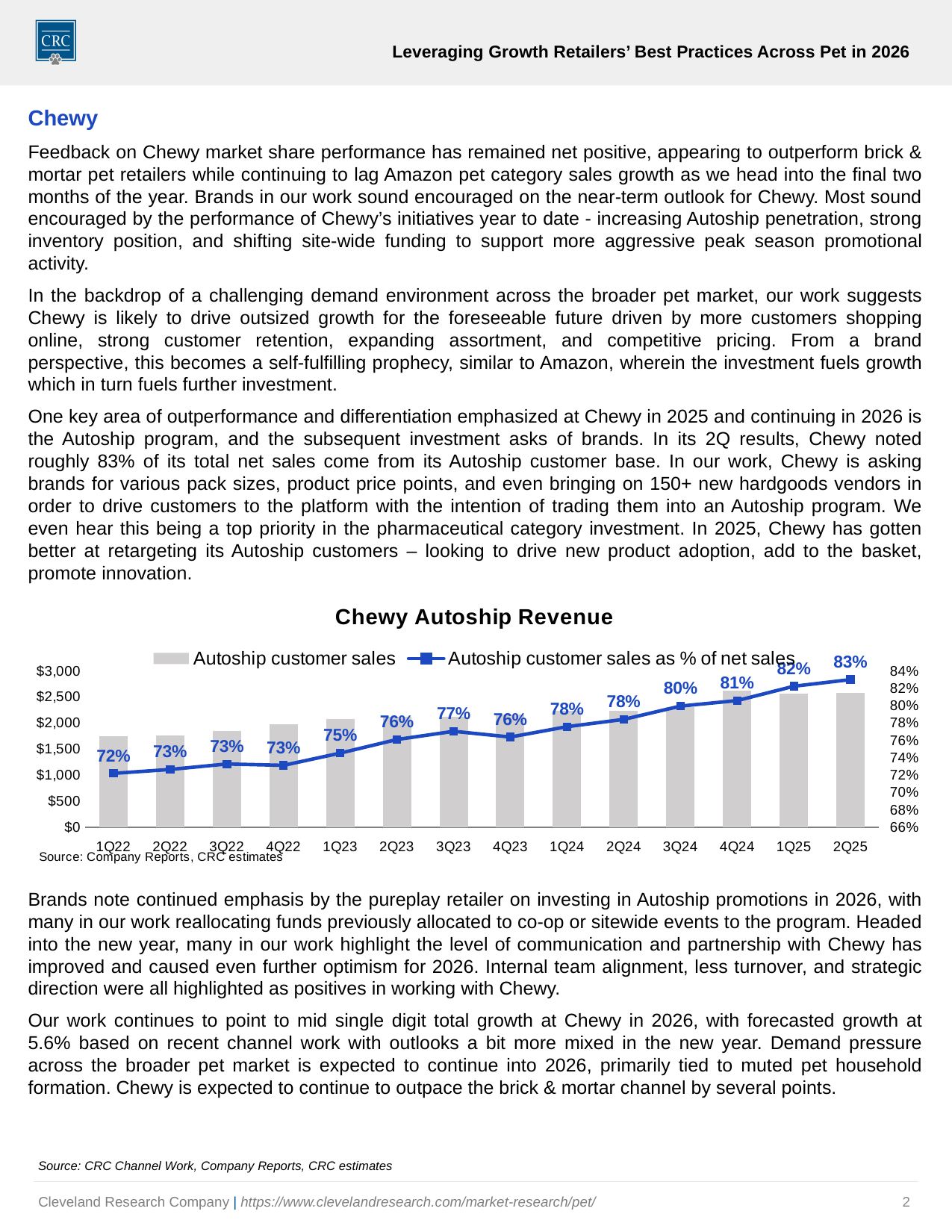
How many series does the legend of the Chewy Autoship Revenue chart list? 2 By how many percentage points did Autoship customer sales as % of net sales increase from 1Q22 to 2Q25? 11 percentage points Which quarter has the lowest Autoship customer sales as % of net sales? 1Q22 What kind of chart is the Chewy Autoship Revenue chart? Combination bar and line chart Which quarter has a higher Autoship customer sales as % of net sales, 3Q23 or 4Q23? 3Q23 Which quarter has the highest Autoship customer sales as % of net sales? 2Q25 What is the value of Autoship customer sales as % of net sales in 1Q22? 72% Is the Autoship customer sales bar for 1Q22 greater or less than $2,000? less What is the value of Autoship customer sales as % of net sales in 2Q25? 83% Does Autoship customer sales as % of net sales generally rise or fall from 1Q22 to 2Q25? Rise How many quarters are shown on the x axis of the Chewy Autoship Revenue chart? 14